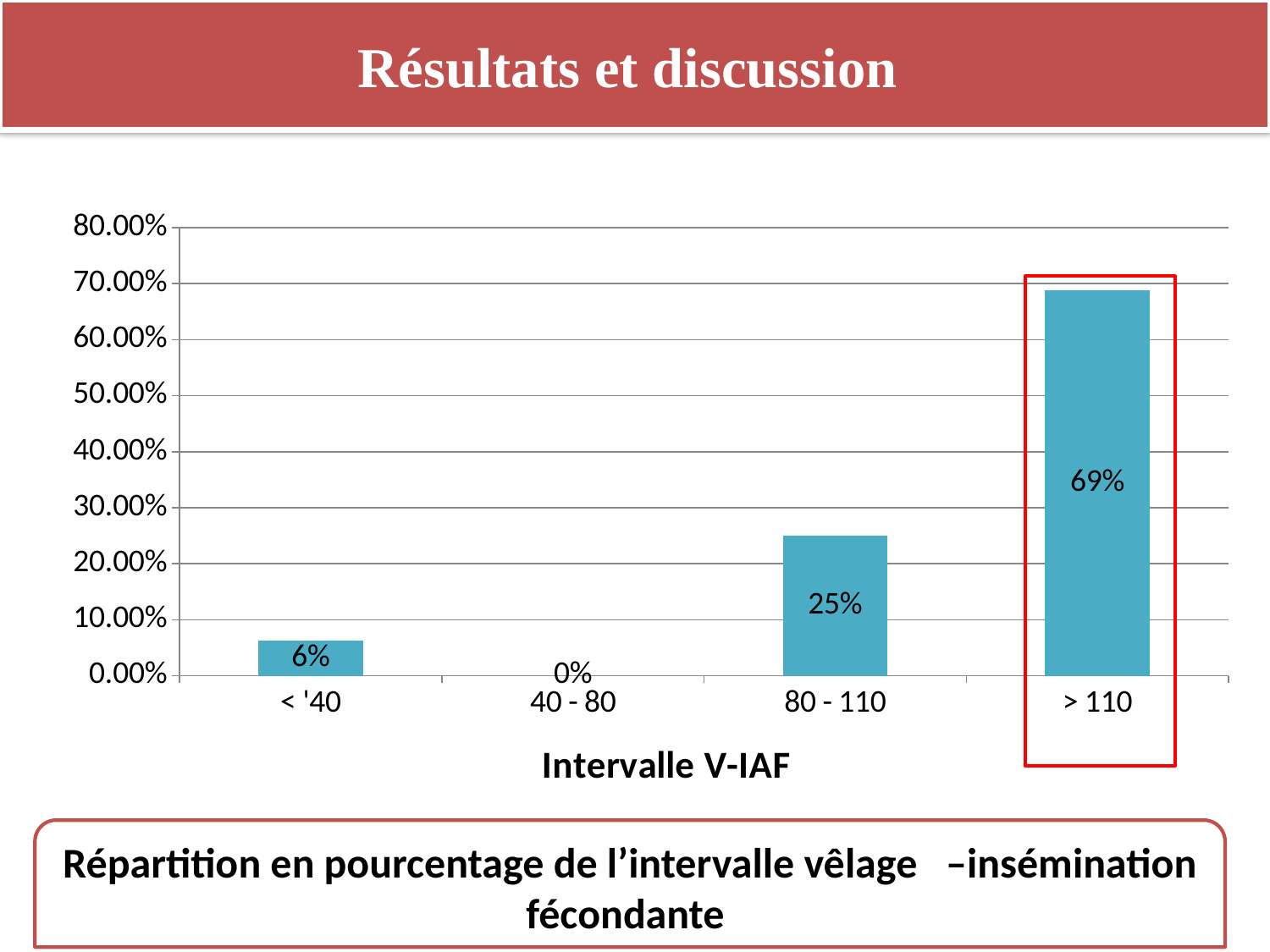
What is the difference between the values for '> 110' and '80 - 110'? 44% Which is larger, the value for '80 - 110' or the value for "< '40"? 80 - 110 What is the x-axis title of the chart? Intervalle V-IAF What is the value for the '> 110' interval? 69% Is the value for '> 110' greater or less than 60.00%? greater What is the value for the "< '40" interval? 6% Which interval has the lowest value? 40 - 80 What kind of chart is shown on the slide? bar chart How many intervals are shown on the x axis? 4 What is the value for the '80 - 110' interval? 25% Which interval has the highest value? > 110 What is the value for the '40 - 80' interval? 0%